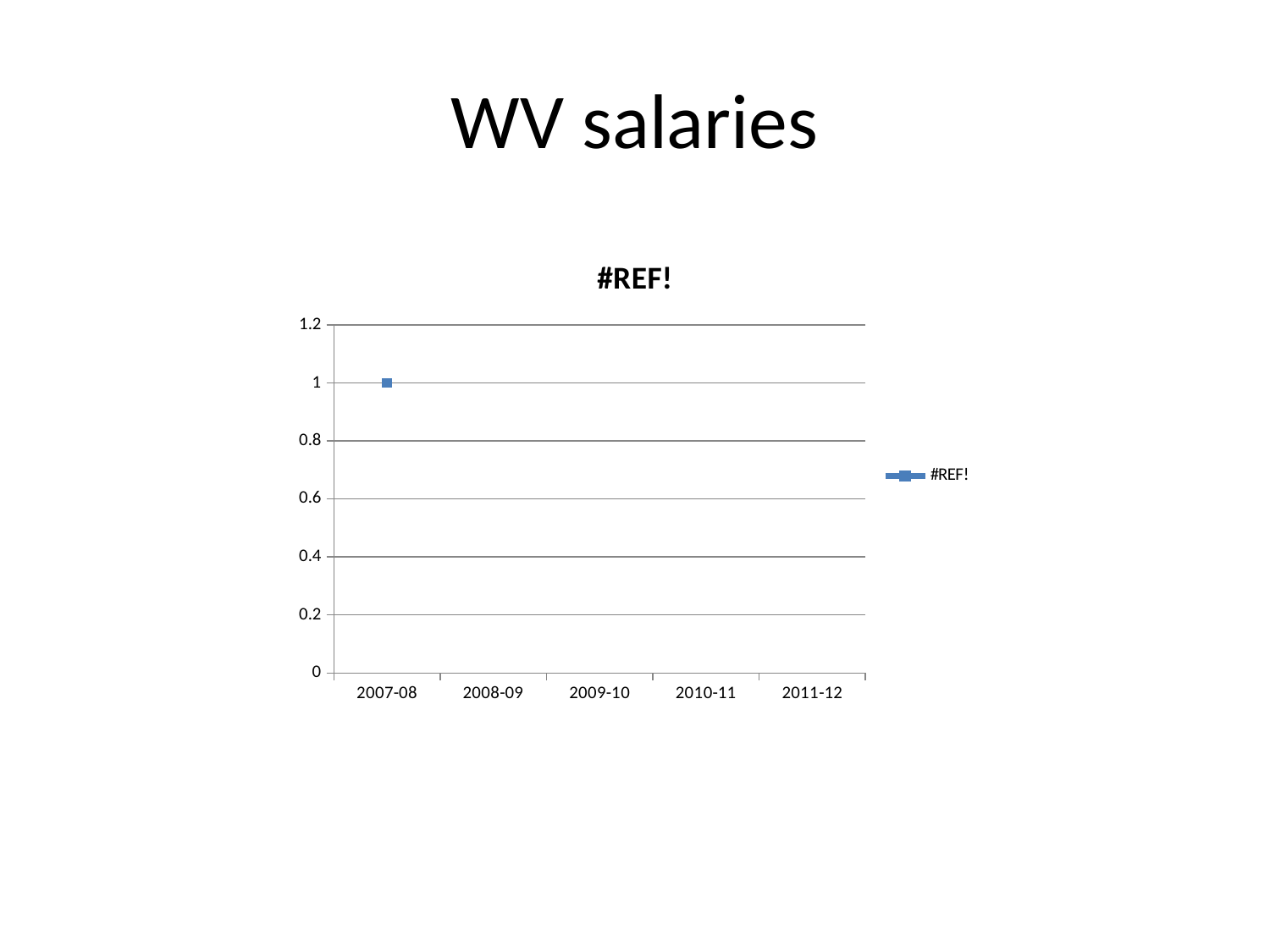
How many data points are actually plotted on the chart? 1 How many series does the chart's legend list? 1 What is the first category on the x axis? 2007-08 What is the name of the series listed in the legend? #REF! What is the last category on the x axis? 2011-12 How many categories are labelled on the x axis of the chart? 5 Is the value for 2007-08 greater or less than 0.8? greater What is the value plotted for 2007-08? 1 What kind of chart is shown on the slide? line chart Which category on the x axis has a plotted data point? 2007-08 What is the title shown above the chart? #REF! Is the value for 2007-08 greater or less than 1.2? less